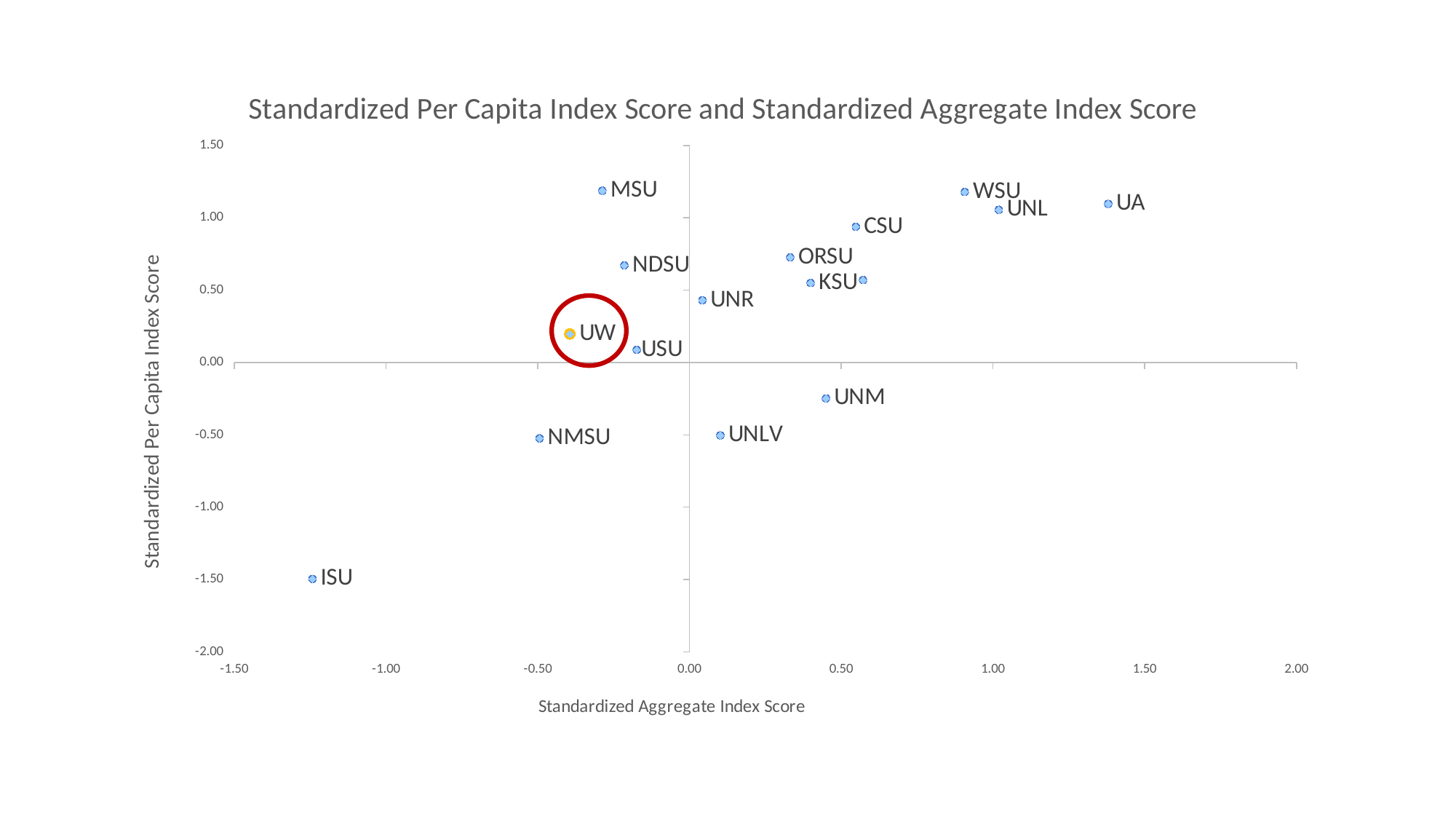
What kind of chart is shown on the slide? Scatter chart Which institution has the lowest Standardized Aggregate Index Score? ISU Which institution has the lowest Standardized Per Capita Index Score? ISU Which has the higher Standardized Aggregate Index Score, NMSU or UNL? UNL Is the Standardized Per Capita Index Score for MSU greater or less than 1.00? greater Which point on the chart is highlighted with a red circle? UW Which has the higher Standardized Per Capita Index Score, CSU or UNM? CSU What is the title of the chart? Standardized Per Capita Index Score and Standardized Aggregate Index Score Is the Standardized Per Capita Index Score for ISU greater or less than -1.00? less Which institution has the highest Standardized Aggregate Index Score? UA Is the Standardized Per Capita Index Score for UNLV greater or less than 0.00? less